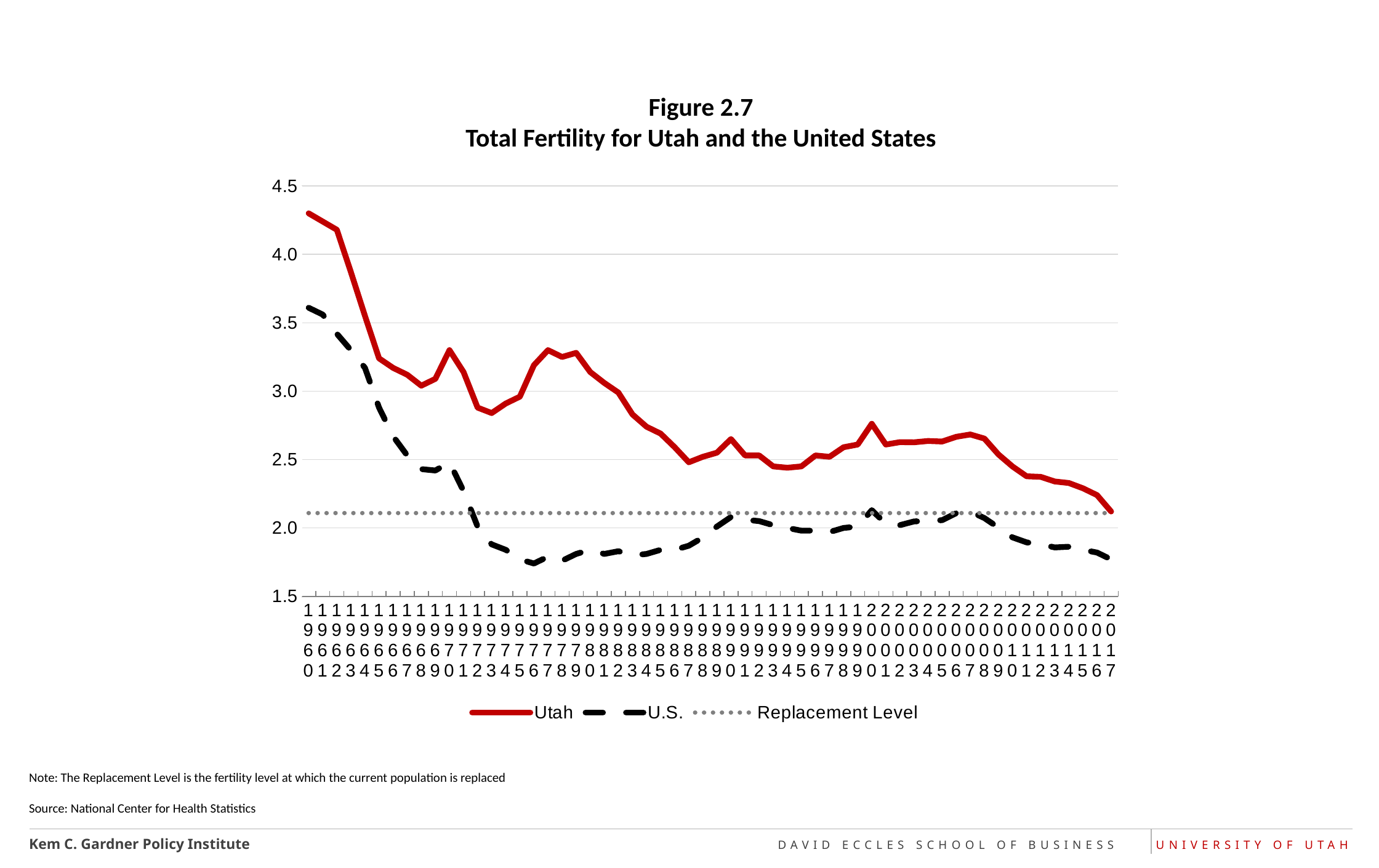
Is the Utah value for 2008 greater or less than 2.5? greater Does the U.S. total fertility rate rise or fall from 1960 to 1976? Fall In 1990, which is larger, the Utah value or the U.S. value? Utah In which year is the Utah total fertility rate highest? 1960 Is the U.S. value for 2017 greater or less than 2.0? less What kind of chart is shown on the slide? Line chart Which series is drawn as a solid red line? Utah What is the title of the chart? Figure 2.7 Total Fertility for Utah and the United States How many series does the legend list? 3 Is the Utah value for 1960 greater or less than 4.0? greater How many years are plotted along the x axis? 58 In which year is the Utah total fertility rate lowest? 2017